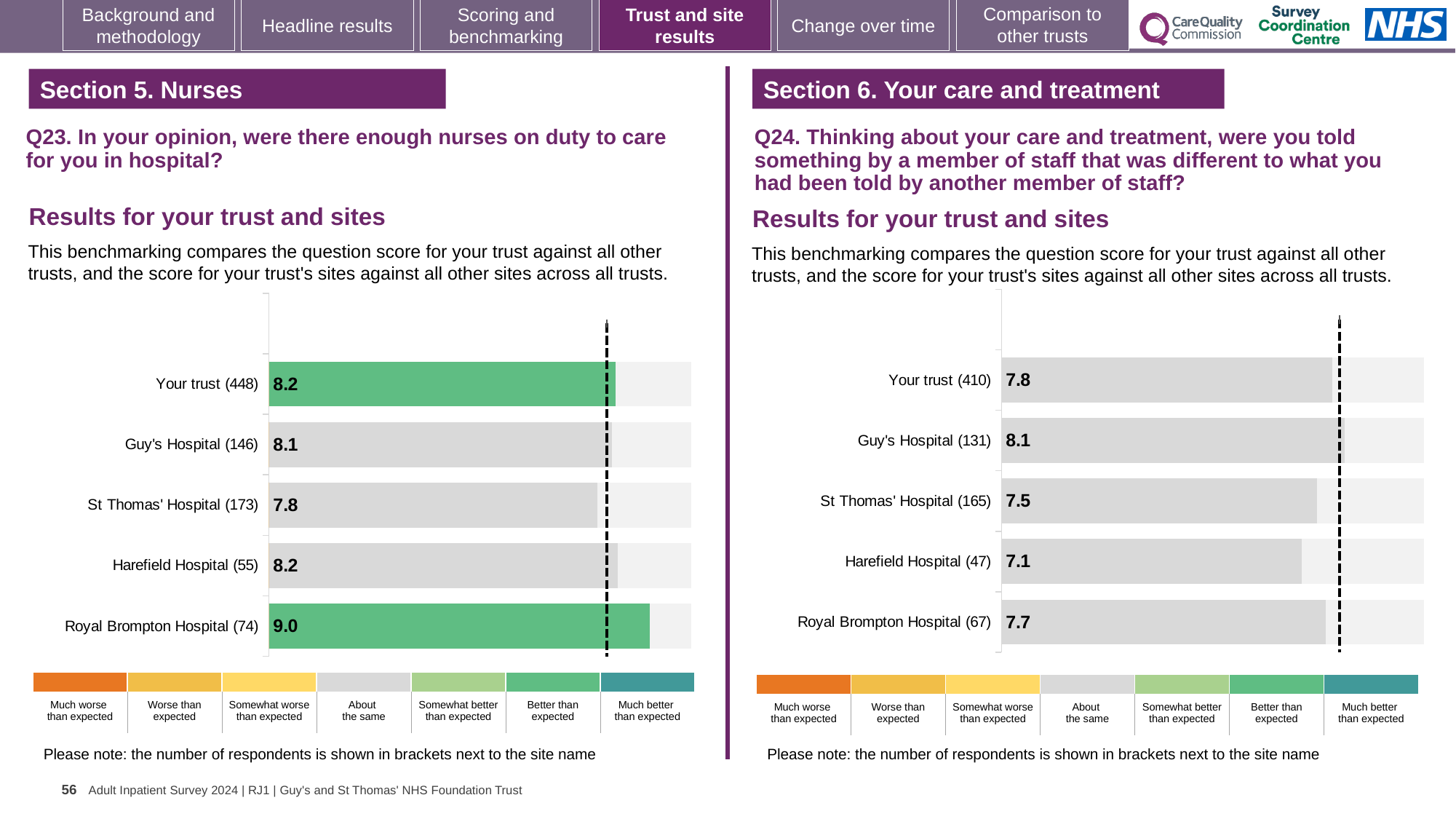
In the Q24 chart on the right, what is the score for Harefield Hospital? 7.1 In the Q24 chart on the right, what is the score for Your trust? 7.8 What kind of chart is used for the Q24 results on the right? Bar chart In the Q23 chart on the left, which site has the lowest score? St Thomas' Hospital How many bars are shown in the Q23 chart on the left? 5 In the Q24 chart on the right, which site has the lowest score? Harefield Hospital In the Q24 chart on the right, which site has the highest score? Guy's Hospital In the Q23 chart on the left, what is the score for Royal Brompton Hospital? 9.0 In the Q24 chart on the right, which has the larger score, Guy's Hospital or St Thomas' Hospital? Guy's Hospital In the Q23 chart on the left, what is the difference between the scores for Royal Brompton Hospital and St Thomas' Hospital? 1.2 In the Q23 chart on the left, which site has the highest score? Royal Brompton Hospital In the Q23 chart on the left, what is the score for St Thomas' Hospital? 7.8